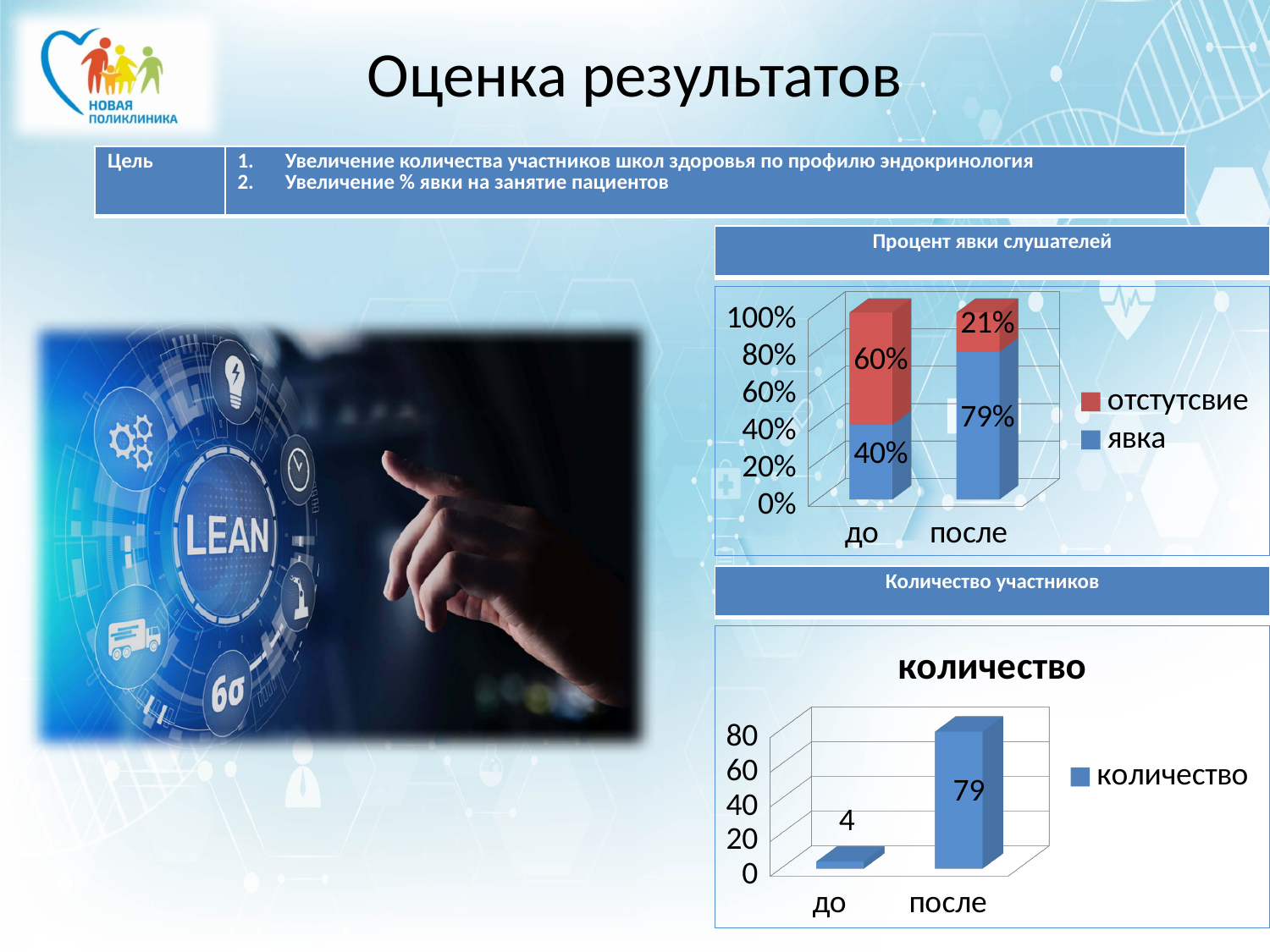
What type of chart is the 'Количество участников' chart? bar chart In the 'Процент явки слушателей' chart, what is the value of 'отстутсвие' for 'до'? 60% In the 'Количество участников' chart, what is the value for 'после'? 79 In the 'Количество участников' chart, what is the difference between 'после' and 'до'? 75 In the 'Процент явки слушателей' chart, what is the value of 'явка' for 'до'? 40% In the 'Процент явки слушателей' chart, what is the value of 'явка' for 'после'? 79% In the 'Процент явки слушателей' chart, which category has the larger 'отстутсвие' value, 'до' or 'после'? до In the 'Процент явки слушателей' chart, how many series does the legend list? 2 In the 'Количество участников' chart, what is the value for 'до'? 4 In the 'Процент явки слушателей' chart, by how much did 'явка' increase from 'до' to 'после'? 39% In the 'Процент явки слушателей' chart, what is the value of 'отстутсвие' for 'после'? 21% In the 'Количество участников' chart, which category has the highest value? после